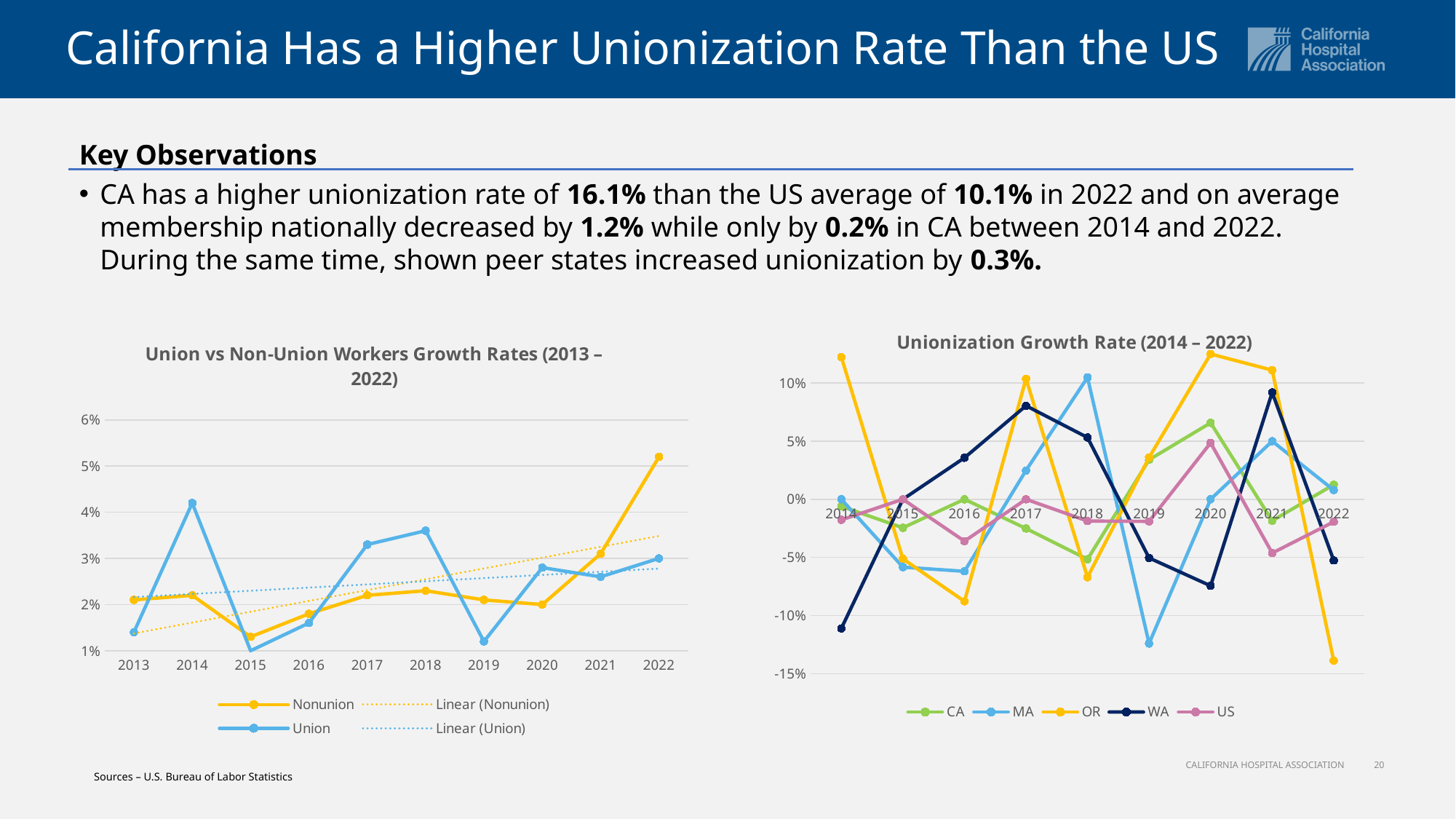
In the 'Union vs Non-Union Workers Growth Rates (2013 – 2022)' chart, how many entries does the legend list? 4 In the 'Union vs Non-Union Workers Growth Rates (2013 – 2022)' chart, is the Nonunion value for 2022 greater or less than 5%? greater In the 'Union vs Non-Union Workers Growth Rates (2013 – 2022)' chart, which series has the larger value in 2014, Union or Nonunion? Union In the 'Union vs Non-Union Workers Growth Rates (2013 – 2022)' chart, how many years are shown on the x axis? 10 In the 'Unionization Growth Rate (2014 – 2022)' chart, in which year is the MA value lowest? 2019 What kind of chart is the 'Union vs Non-Union Workers Growth Rates (2013 – 2022)' chart? Line chart In the 'Unionization Growth Rate (2014 – 2022)' chart, is the OR value for 2022 greater or less than -10%? less In the 'Unionization Growth Rate (2014 – 2022)' chart, does the OR line rise or fall from 2021 to 2022? Fall In the 'Union vs Non-Union Workers Growth Rates (2013 – 2022)' chart, in which year is the Nonunion growth rate lowest? 2015 In the 'Union vs Non-Union Workers Growth Rates (2013 – 2022)' chart, in which year is the Union growth rate highest? 2014 In the 'Unionization Growth Rate (2014 – 2022)' chart, which series has the larger value in 2014, OR or WA? OR In the 'Unionization Growth Rate (2014 – 2022)' chart, how many series does the legend list? 5